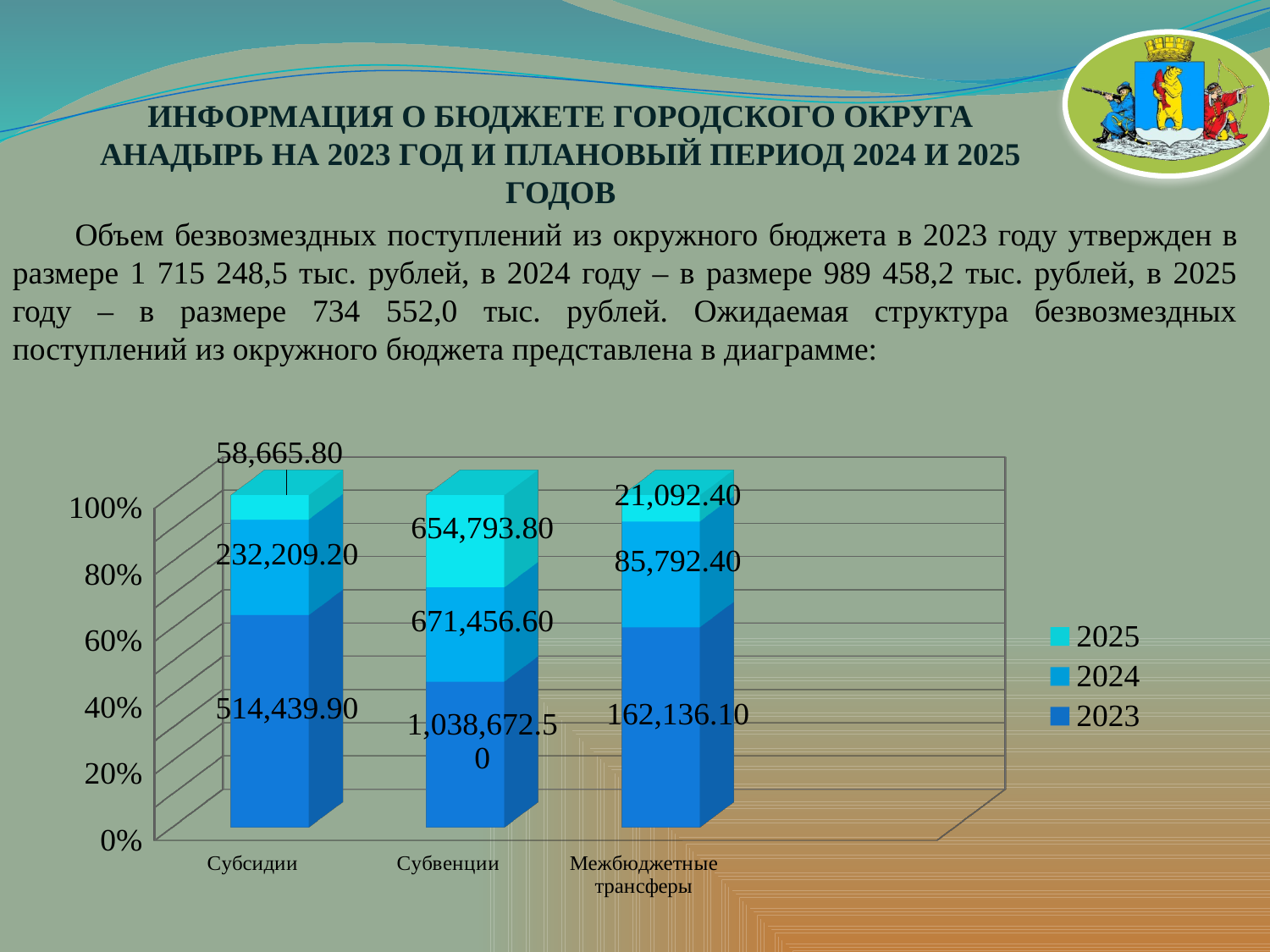
What kind of chart is shown on the slide? Stacked bar chart What is the value for Субвенции in the 2024 series? 671,456.60 How many series does the legend list? 3 How many categories are shown on the x axis? 3 What is the value for Субвенции in the 2023 series? 1,038,672.50 What is the total of the three values stacked in the Межбюджетные трансферы bar? 269,020.90 What is the value for Субсидии in the 2023 series? 514,439.90 What is the difference between the 2023 values for Субвенции and Субсидии? 524,232.60 Which is larger in the 2024 series: Субсидии or Межбюджетные трансферы? Субсидии Which category has the highest value in the 2023 series? Субвенции What is the value for Межбюджетные трансферы in the 2025 series? 21,092.40 Which category has the lowest value in the 2025 series? Межбюджетные трансферы